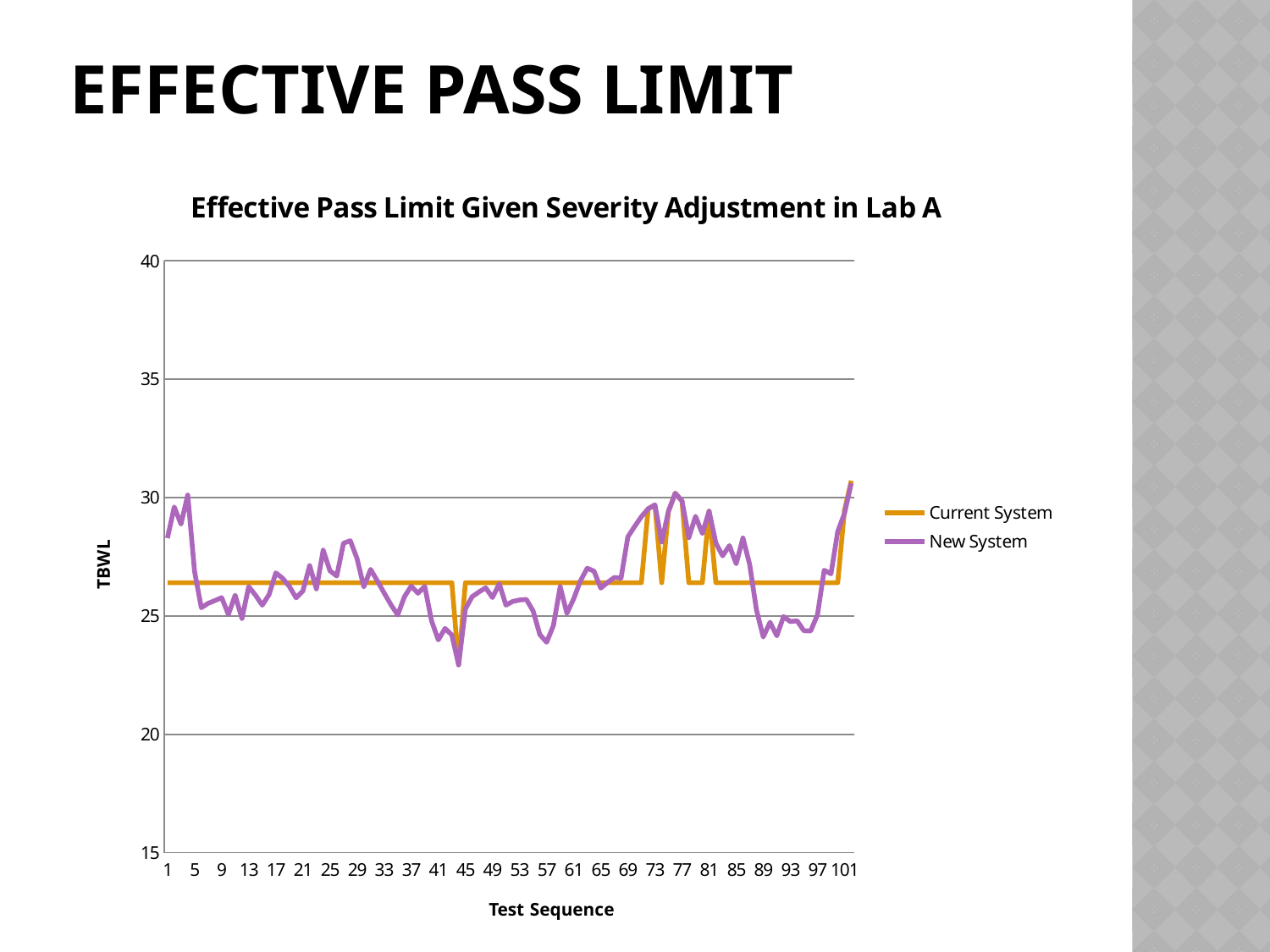
Is the value for the Current System at test sequence 1 greater or less than 30? less At test sequence 1, which series has the higher value, Current System or New System? New System At test sequence 89, which series has the higher value, Current System or New System? Current System What is the title of the chart? Effective Pass Limit Given Severity Adjustment in Lab A Is the value for the Current System at test sequence 21 greater or less than 25? greater How many series does the legend list? 2 Is the value for the New System at test sequence 89 greater or less than 25? less What is the label of the vertical axis? TBWL What kind of chart is shown on the slide? line chart